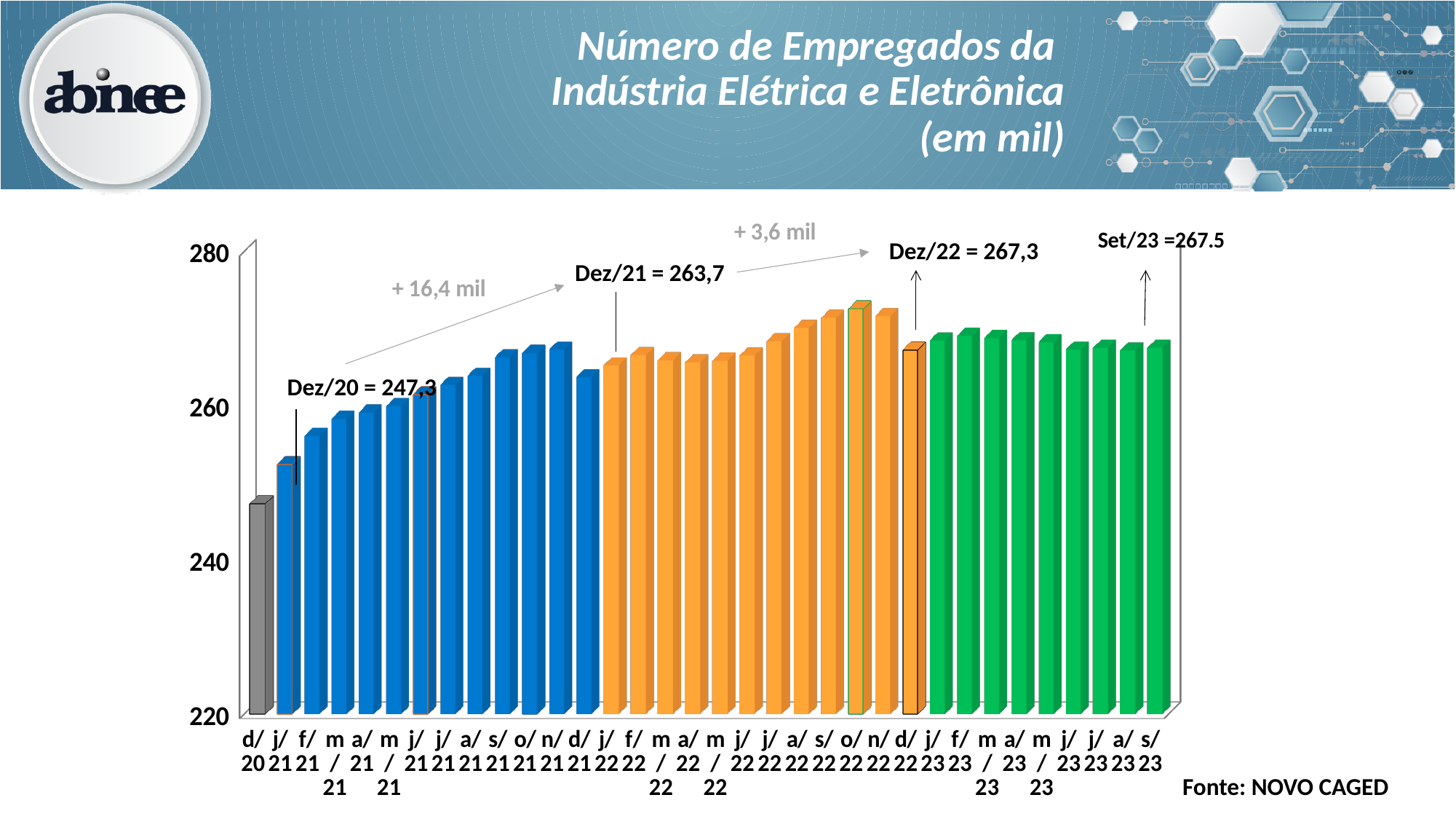
By how much did the number of employees increase from Dez/20 to Dez/21, according to the chart? 16,4 mil Which is larger, the value for Dez/21 or the value for Dez/22? Dez/22 What value is labelled for Set/23 on the chart? 267.5 By how much did the number of employees increase from Dez/21 to Dez/22, according to the chart? 3,6 mil What value is labelled for Dez/21 on the chart? 263,7 Is the value for d/20 greater or less than 260? less Do the values rise or fall from d/20 to d/21? rise Which month has the lowest bar on the chart? d/20 What value is labelled for Dez/22 on the chart? 267,3 What value is labelled for Dez/20 on the chart? 247,3 What kind of chart is shown on the slide? bar chart What source is cited for the chart data? NOVO CAGED